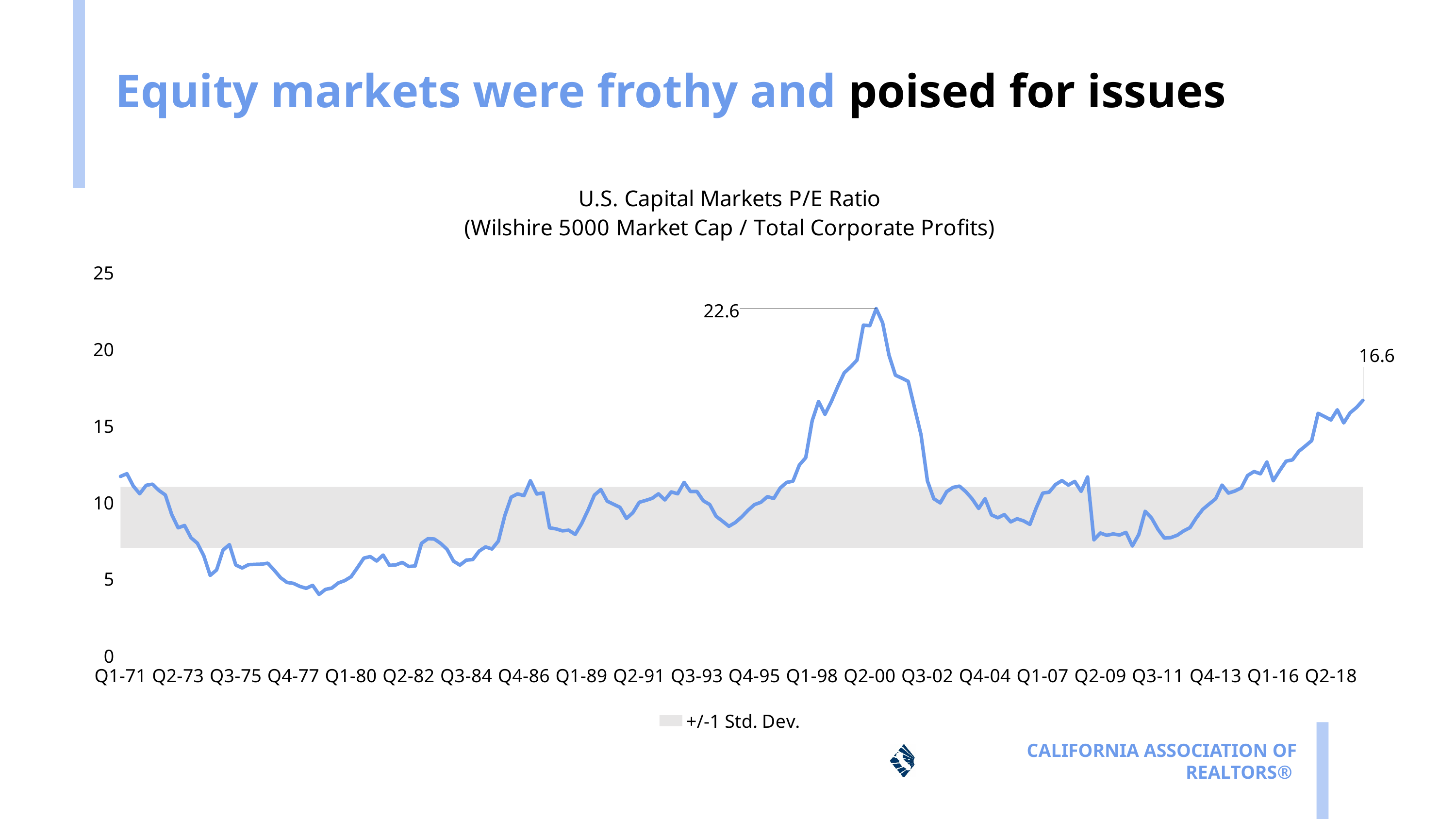
What is the difference between the labeled peak value and the labeled final value of the P/E ratio? 6.0 Which is larger: the labeled peak value around Q2-00 or the labeled final value? the peak value around Q2-00 (22.6) What does the shaded grey band in the chart represent, according to the legend? +/-1 Std. Dev. Is the P/E ratio at Q2-09 greater or less than 10? less What is the value labeled at the end of the P/E ratio line (the most recent point)? 16.6 What kind of chart is shown on the slide? line chart Does the P/E ratio generally rise or fall between Q3-11 and Q2-18? rise Is the P/E ratio at Q1-80 greater or less than 10? less What is the highest value labeled on the P/E ratio line? 22.6 What is the title of the chart? U.S. Capital Markets P/E Ratio (Wilshire 5000 Market Cap / Total Corporate Profits) Is the P/E ratio at Q1-71 greater or less than the value at Q1-80? greater Is the P/E ratio at Q1-71 greater or less than 10? greater